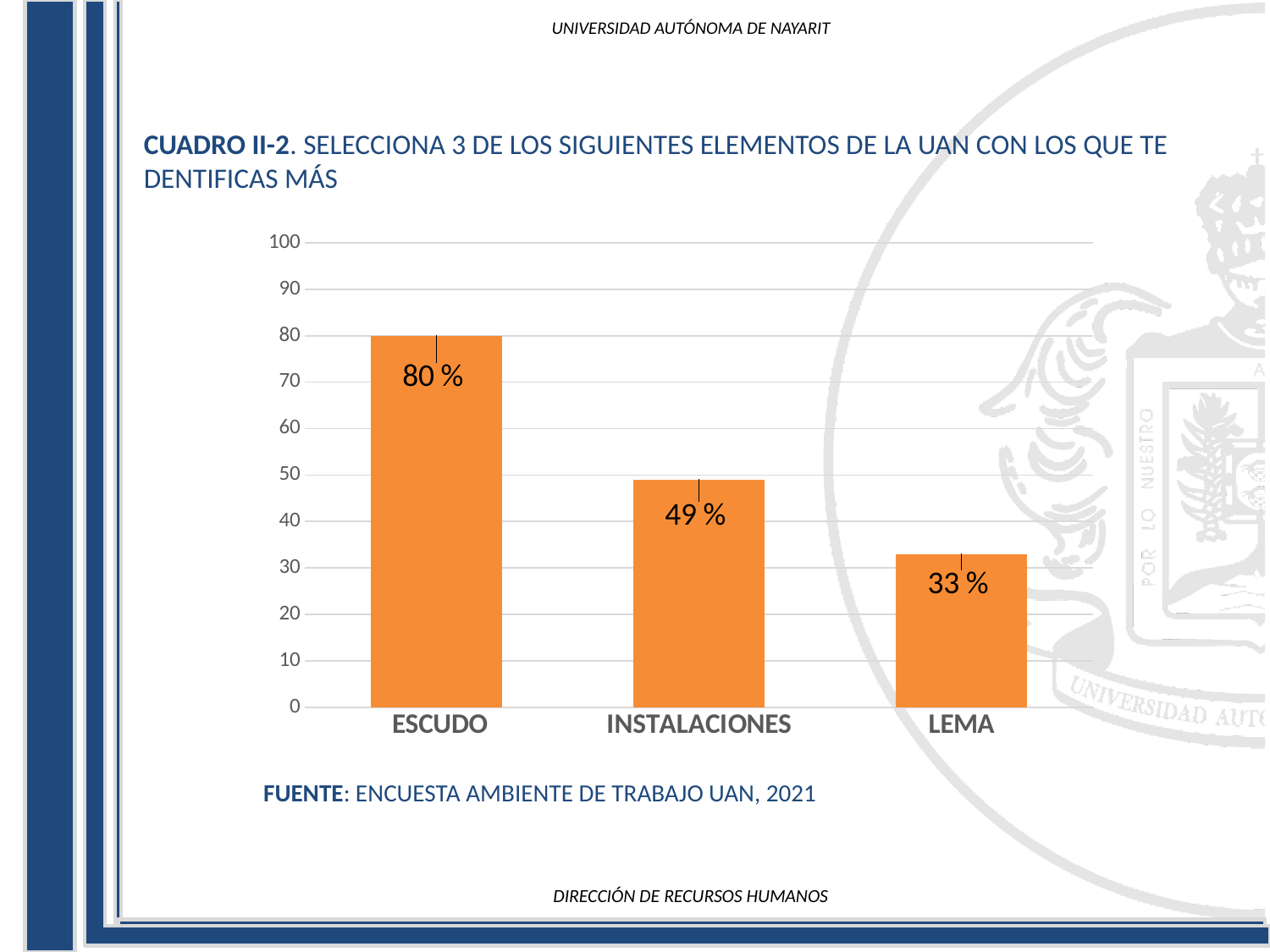
Which is larger, the value for INSTALACIONES or the value for LEMA? INSTALACIONES Which category has the lowest value? LEMA How many categories are shown in the chart? 3 What is the difference between the values for ESCUDO and INSTALACIONES? 31 % Is the value for INSTALACIONES greater or less than 50? less What is the value for INSTALACIONES? 49 % Do the values rise or fall from left to right along the x axis? fall What is the difference between the values for INSTALACIONES and LEMA? 16 % What is the value for LEMA? 33 % What is the value for ESCUDO? 80 % Which category has the highest value? ESCUDO What kind of chart is shown on the slide? bar chart